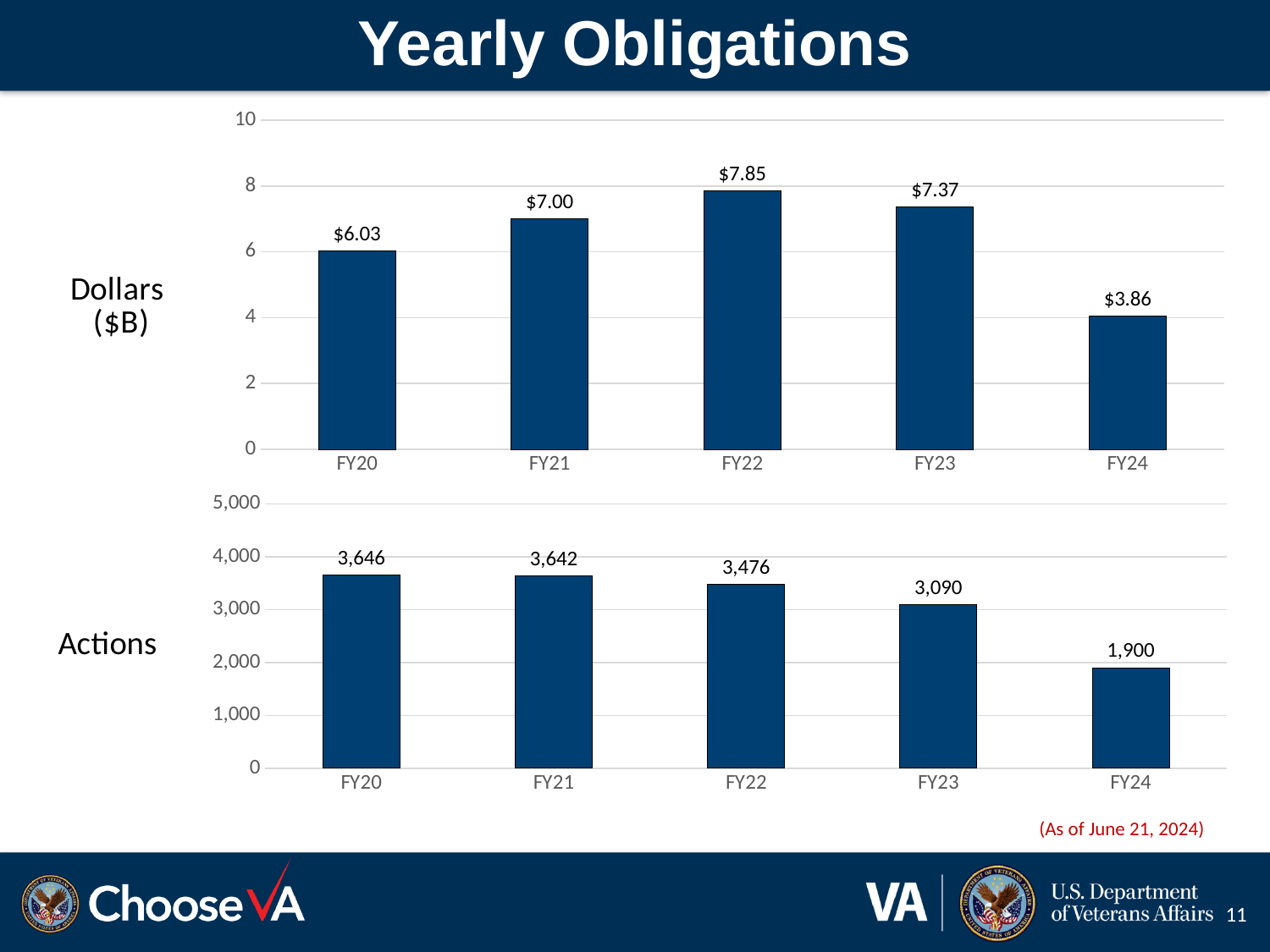
In the Dollars ($B) chart, which fiscal year has the highest value? FY22 What kind of chart is the Dollars ($B) chart? bar chart In the Actions chart, what is the difference between FY20 and FY24? 1,746 In the Dollars ($B) chart, which is larger, FY21 or FY23? FY23 What is the title of the slide containing the two charts? Yearly Obligations In the Dollars ($B) chart, what is the value for FY22? $7.85 In the Actions chart, which fiscal year has the lowest value? FY24 How many fiscal years are shown in the Actions chart? 5 In the Actions chart, is the value for FY22 greater or less than 3,000? greater In the Actions chart, what is the value for FY23? 3,090 In the Actions chart, do the values rise or fall from FY20 to FY24? fall In the Dollars ($B) chart, what is the difference between FY22 and FY24? $3.99